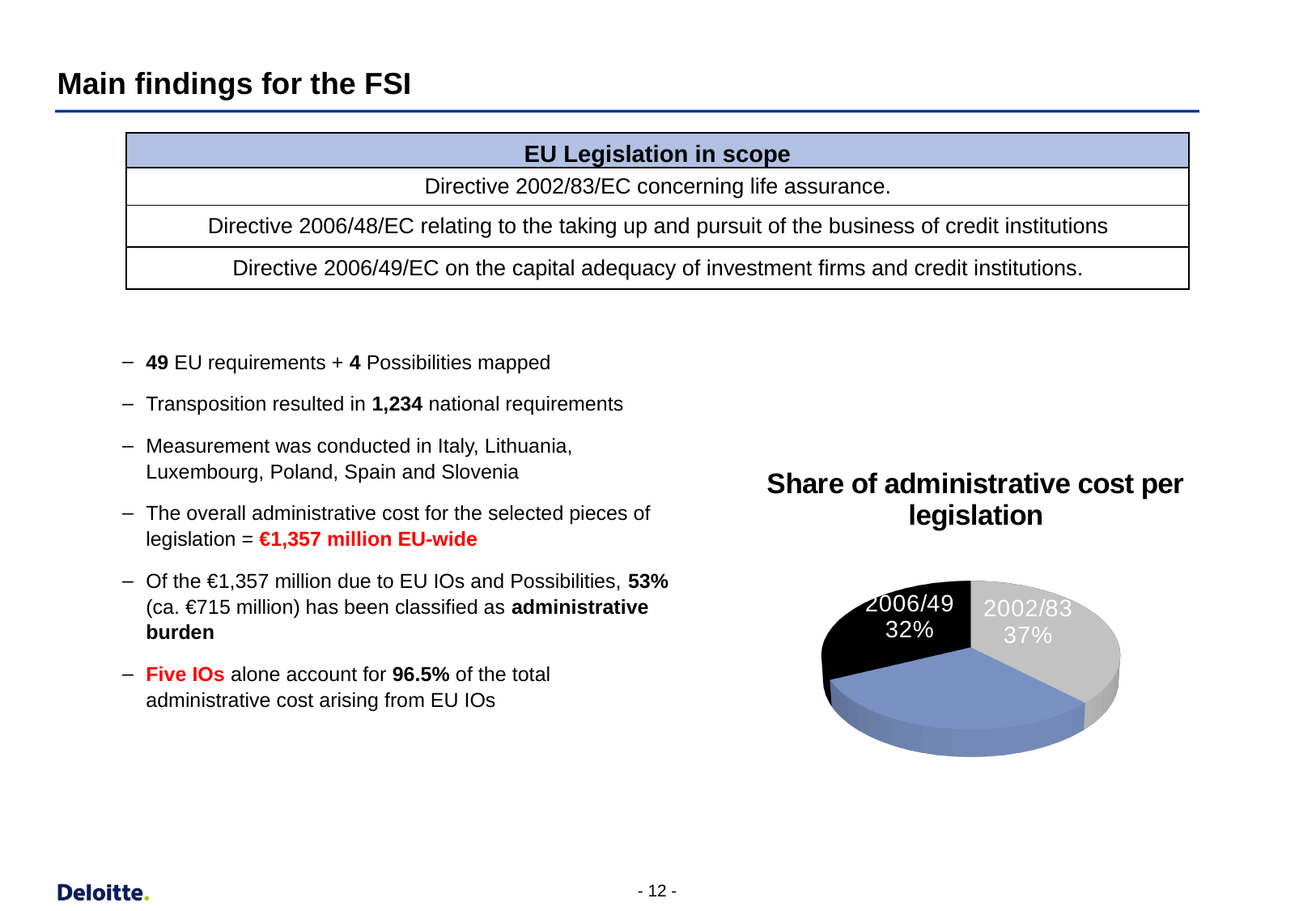
Which has the larger share, 2002/83 or 2006/49? 2002/83 What is the title of the chart on the slide? Share of administrative cost per legislation What share of administrative cost does the 2006/49 slice represent? 32% What is the difference between the shares of 2002/83 and 2006/49? 5 percentage points What share of administrative cost does the 2002/83 slice represent? 37% What colour is the 2006/49 slice in the pie chart? black How many slices does the pie chart have? 3 What kind of chart is shown on the slide? pie chart